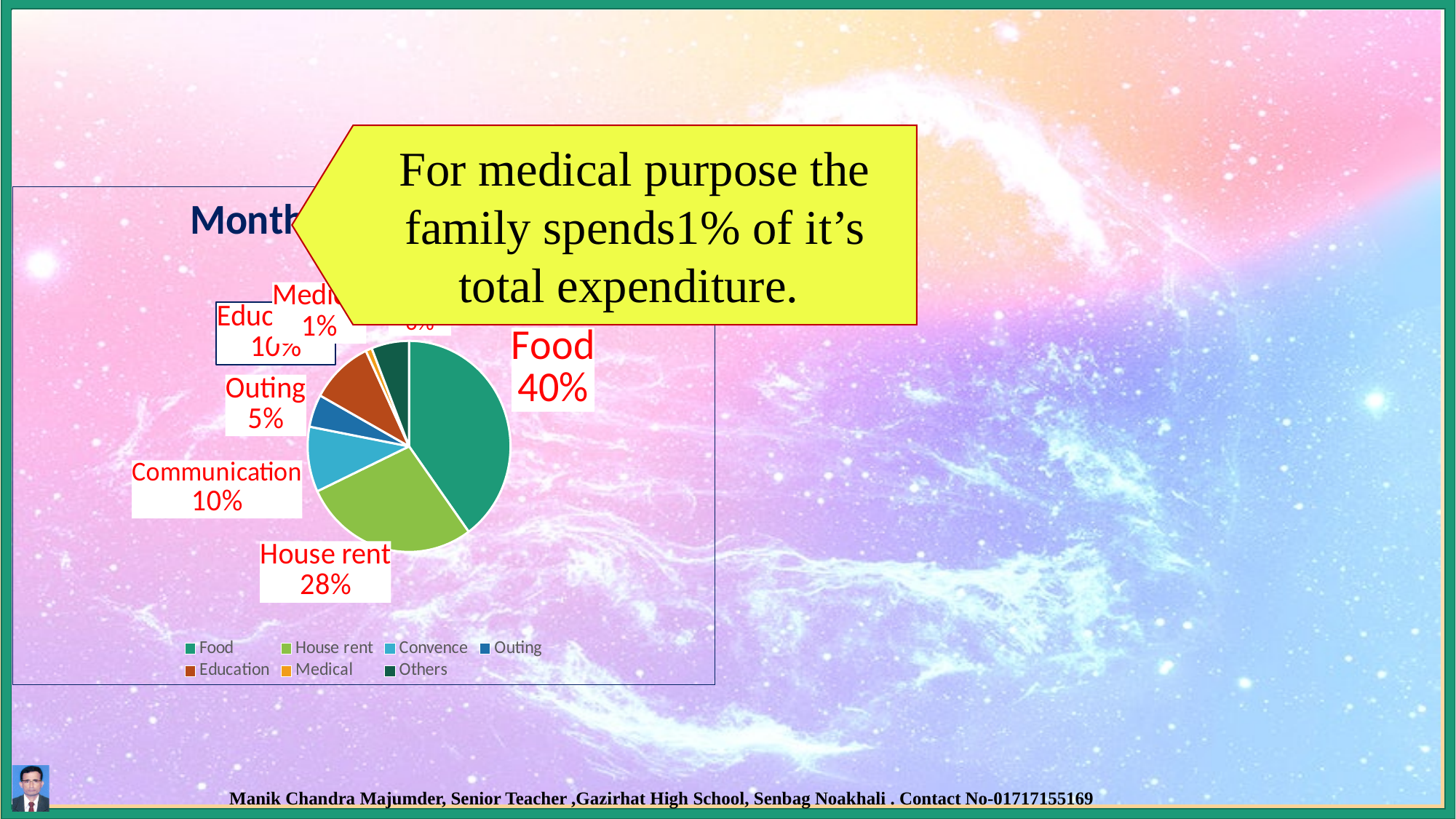
Which is larger, the share for House rent or the share for Communication? House rent What percentage of the expenditure is spent on House rent? 28% What percentage is spent on Outing? 5% What share of the expenditure is for Communication? 10% What kind of chart is shown on the slide? pie chart Which category has the largest share of the pie? Food What is the combined share of Food and House rent? 68% Which category has the smallest share of the pie? Medical What percentage of the total expenditure is spent on Medical? 1% What percentage of the monthly expenditure goes to Food? 40% How many percentage points larger is the Food share than the House rent share? 12% How many categories does the legend list? 7